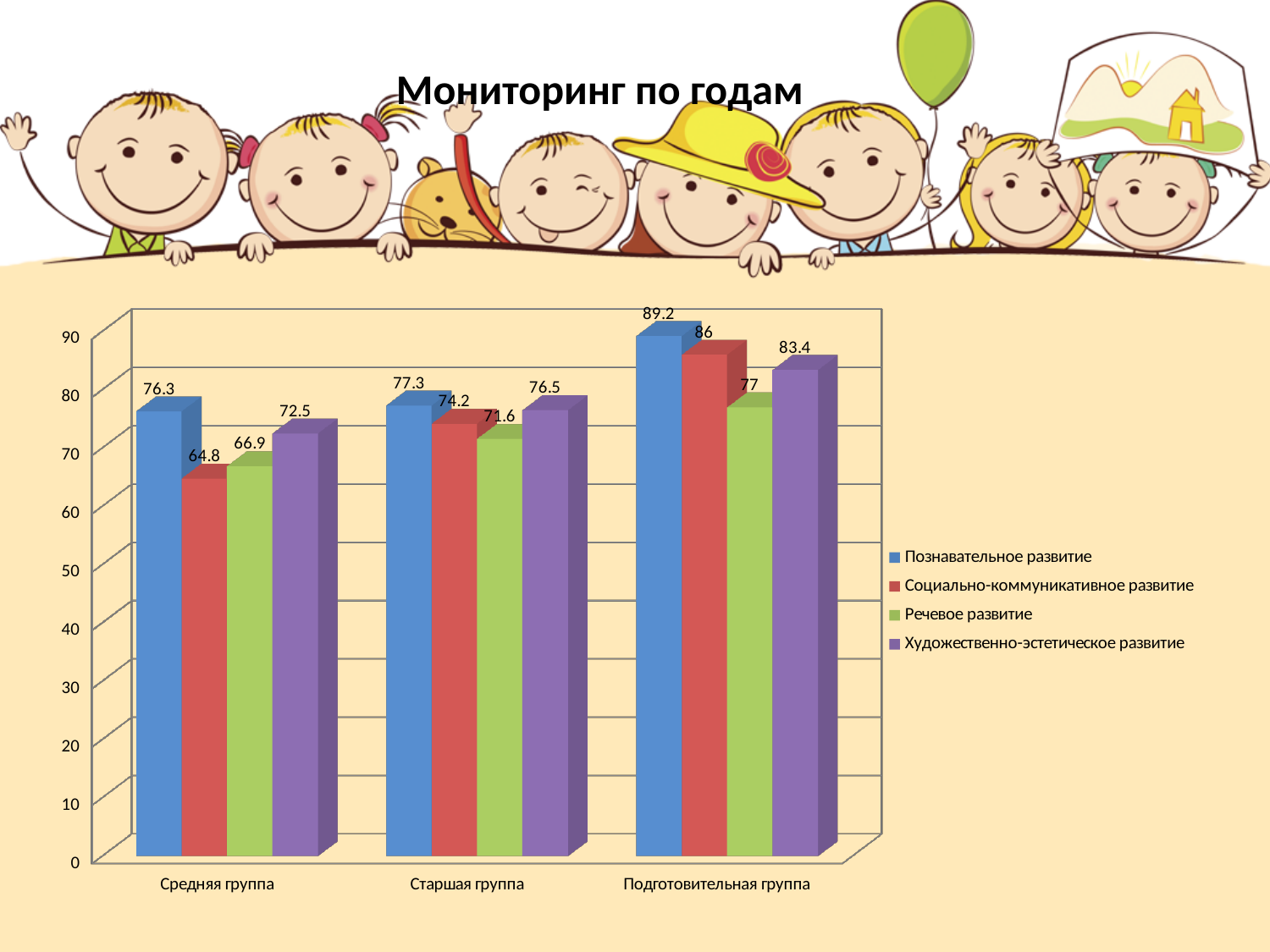
Which group has the highest value for Социально-коммуникативное развитие? Подготовительная группа Do the values for Речевое развитие rise or fall from Средняя группа to Подготовительная группа? Rise What is the difference between Познавательное развитие in Подготовительная группа and in Средняя группа? 12.9 What is the value for Речевое развитие in Старшая группа? 71.6 How many series does the legend list? 4 What is the value for Художественно-эстетическое развитие in Подготовительная группа? 83.4 Which is larger: Речевое развитие in Старшая группа or Художественно-эстетическое развитие in Старшая группа? Художественно-эстетическое развитие How many groups are shown on the x axis? 3 What is the value for Познавательное развитие in Средняя группа? 76.3 Which series has the lowest value in Средняя группа? Социально-коммуникативное развитие What kind of chart is shown on the slide? Bar chart What is the title of the slide? Мониторинг по годам